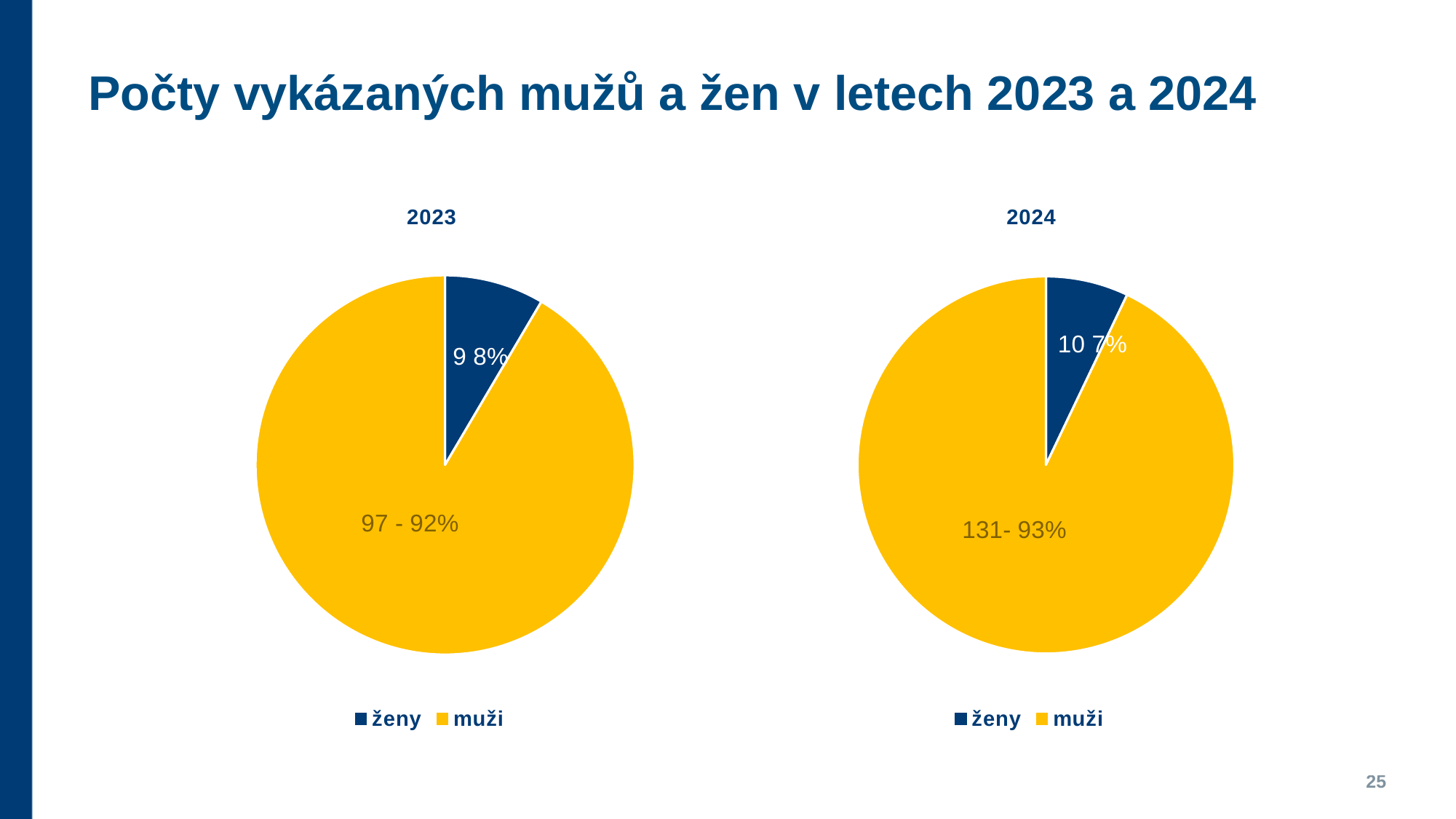
What type of chart is used for the 2023 data? pie chart In the 2024 chart, what percentage share does the muži slice have? 93% In the 2023 chart, what percentage share does the ženy slice have? 8% In the 2023 chart, which colour represents ženy? dark blue In the 2024 chart, what count is printed on the muži slice? 131 In the 2024 chart, what percentage share does the ženy slice have? 7% In the 2023 chart, which category has the largest slice? muži In the 2024 chart, what count is printed on the ženy slice? 10 In the 2024 chart, which category has the smallest slice? ženy How many categories does the legend of the 2024 chart list? 2 In the 2023 chart, what count is printed on the muži slice? 97